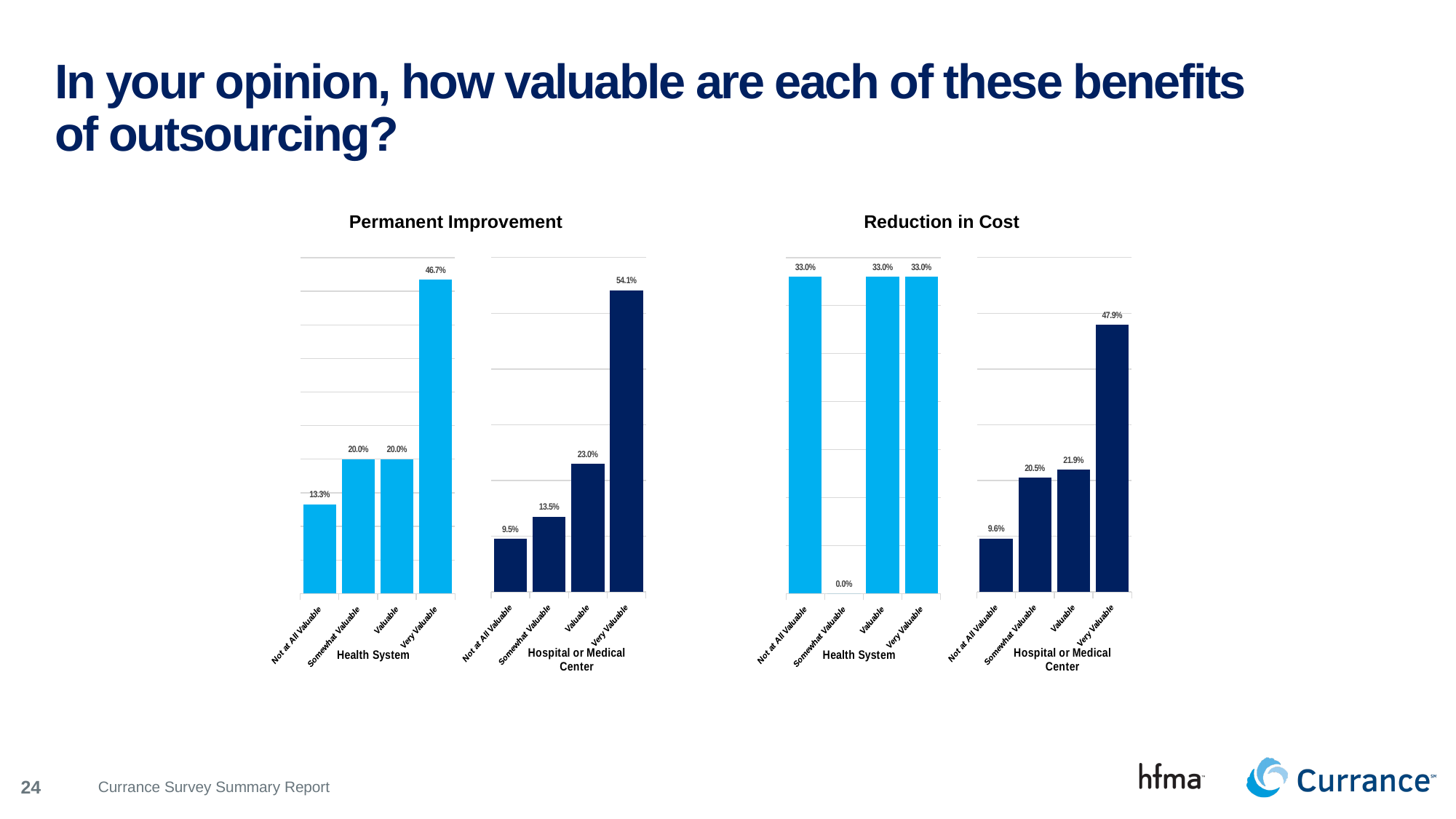
In the Permanent Improvement chart, which is larger for Health System: Not at All Valuable or Somewhat Valuable? Somewhat Valuable In the Permanent Improvement chart, what percentage of Health System respondents rated it Very Valuable? 46.7% In the Permanent Improvement chart, what is the difference between the Very Valuable values for Hospital or Medical Center and Health System? 7.4% In the Reduction in Cost chart, what percentage of Health System respondents rated it Somewhat Valuable? 0.0% In the Reduction in Cost chart, how many rating categories are shown for Health System? 4 What type of chart is used for Permanent Improvement? Bar chart In the Reduction in Cost chart, what is the difference between the Very Valuable and Not at All Valuable values for Hospital or Medical Center? 38.3% In the Permanent Improvement chart, do the Hospital or Medical Center values rise or fall from Not at All Valuable to Very Valuable? Rise In the Permanent Improvement chart, which rating has the lowest value for Hospital or Medical Center? Not at All Valuable In the Reduction in Cost chart, which rating has the highest value for Hospital or Medical Center? Very Valuable In the Permanent Improvement chart, what percentage of Hospital or Medical Center respondents rated it Very Valuable? 54.1% In the Reduction in Cost chart, what percentage of Hospital or Medical Center respondents rated it Valuable? 21.9%